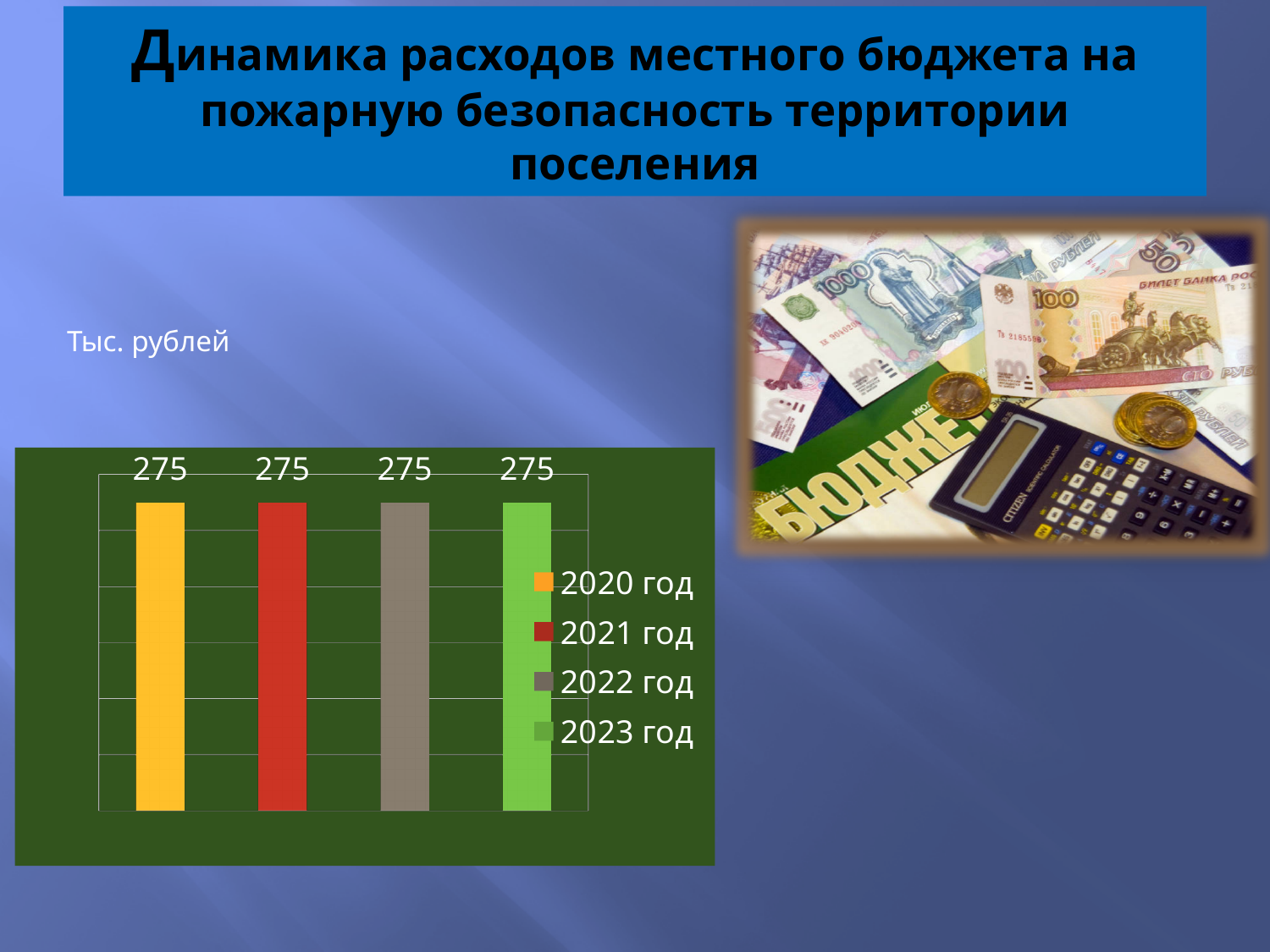
What is the value for 2021 год? 275 Do the values rise, fall, or stay the same from 2020 год to 2023 год? stay the same What unit of measurement is stated for the chart values? Тыс. рублей Which legend entry is shown in red? 2021 год What is the value for 2023 год? 275 How many entries does the legend list? 4 What kind of chart is shown on the slide? bar chart What is the value for 2020 год? 275 How many bars are plotted in the chart? 4 What is the value for 2022 год? 275 What is the difference between the values for 2023 год and 2020 год? 0 Is the value for 2021 год larger than, smaller than, or equal to the value for 2022 год? equal